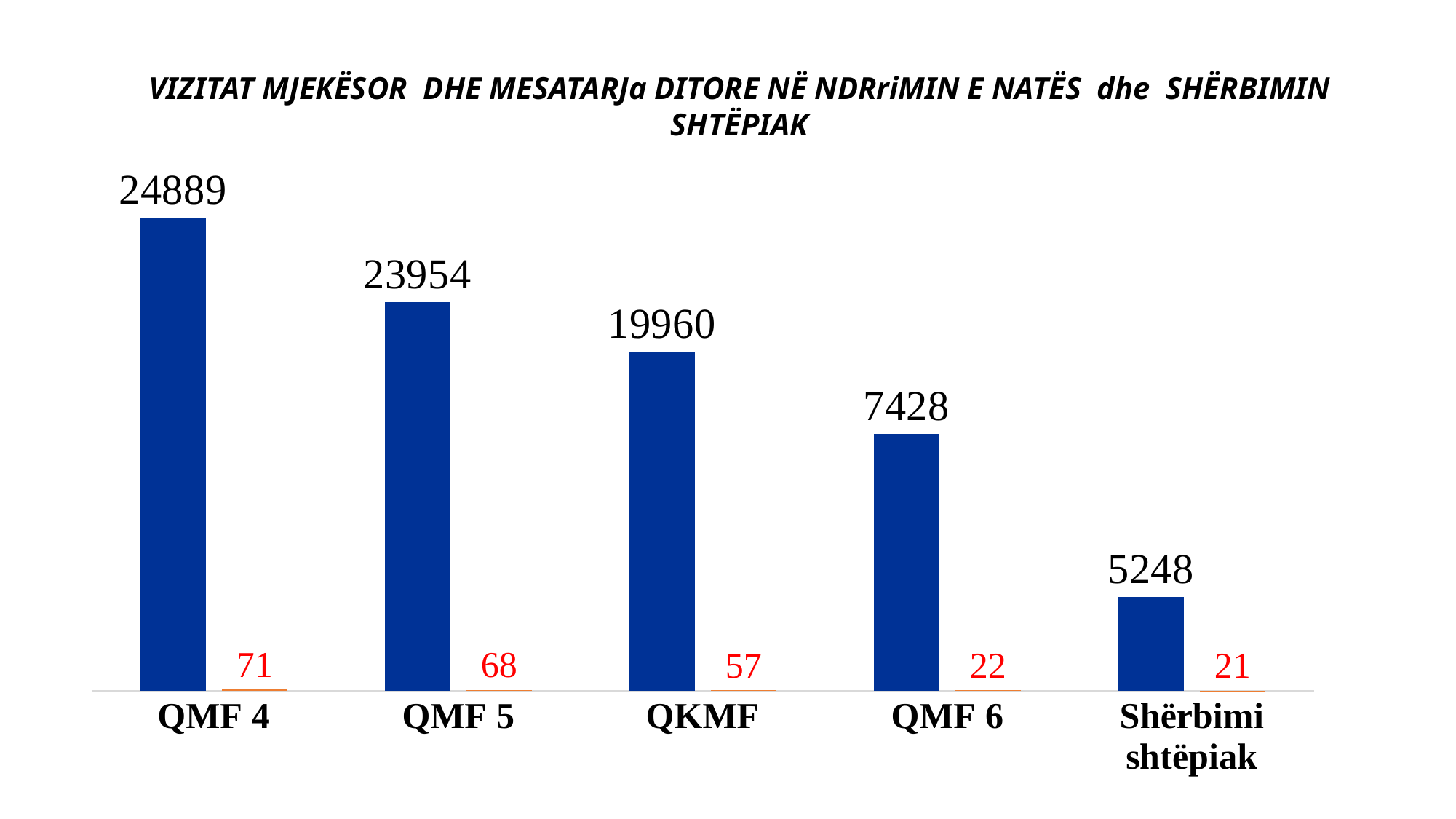
How many categories are shown on the x axis? 5 What is the red-labelled value shown for QMF 5? 68 Which category has the highest blue bar? QMF 4 What is the red-labelled value shown for QMF 6? 22 What kind of chart is shown on the slide? Bar chart What is the difference between the blue bar values for QMF 4 and QMF 5? 935 What is the value of the blue bar for QMF 4? 24889 Which has a larger blue bar value, QKMF or QMF 6? QKMF What is the value of the blue bar for QKMF? 19960 Which category has the lowest blue bar? Shërbimi shtëpiak What is the difference between the blue bar values for QMF 6 and Shërbimi shtëpiak? 2180 What is the value of the blue bar for Shërbimi shtëpiak? 5248